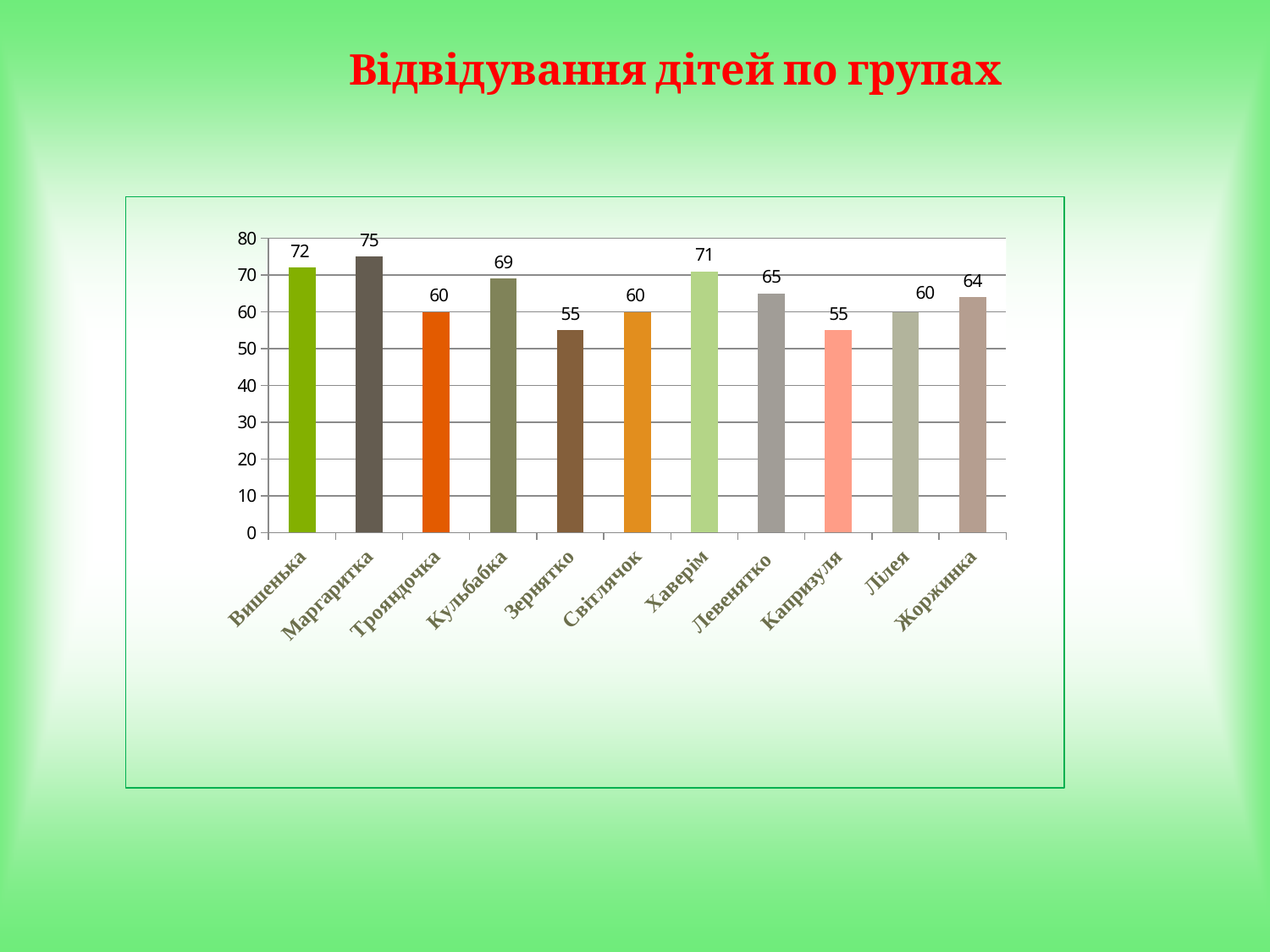
Which group has the highest value? Маргаритка What is the value for Левенятко? 65 What is the value for Маргаритка? 75 What is the difference between the values for Маргаритка and Зернятко? 20 What is the value for Жоржинка? 64 What is the title of the slide? Відвідування дітей по групах What type of chart is shown on the slide? bar chart Which is larger, the value for Хаверім or the value for Левенятко? Хаверім What is the value for Кульбабка? 69 How many groups are shown on the x axis? 11 Is the value for Капризуля greater or less than 60? less What is the difference between the values for Вишенька and Хаверім? 1